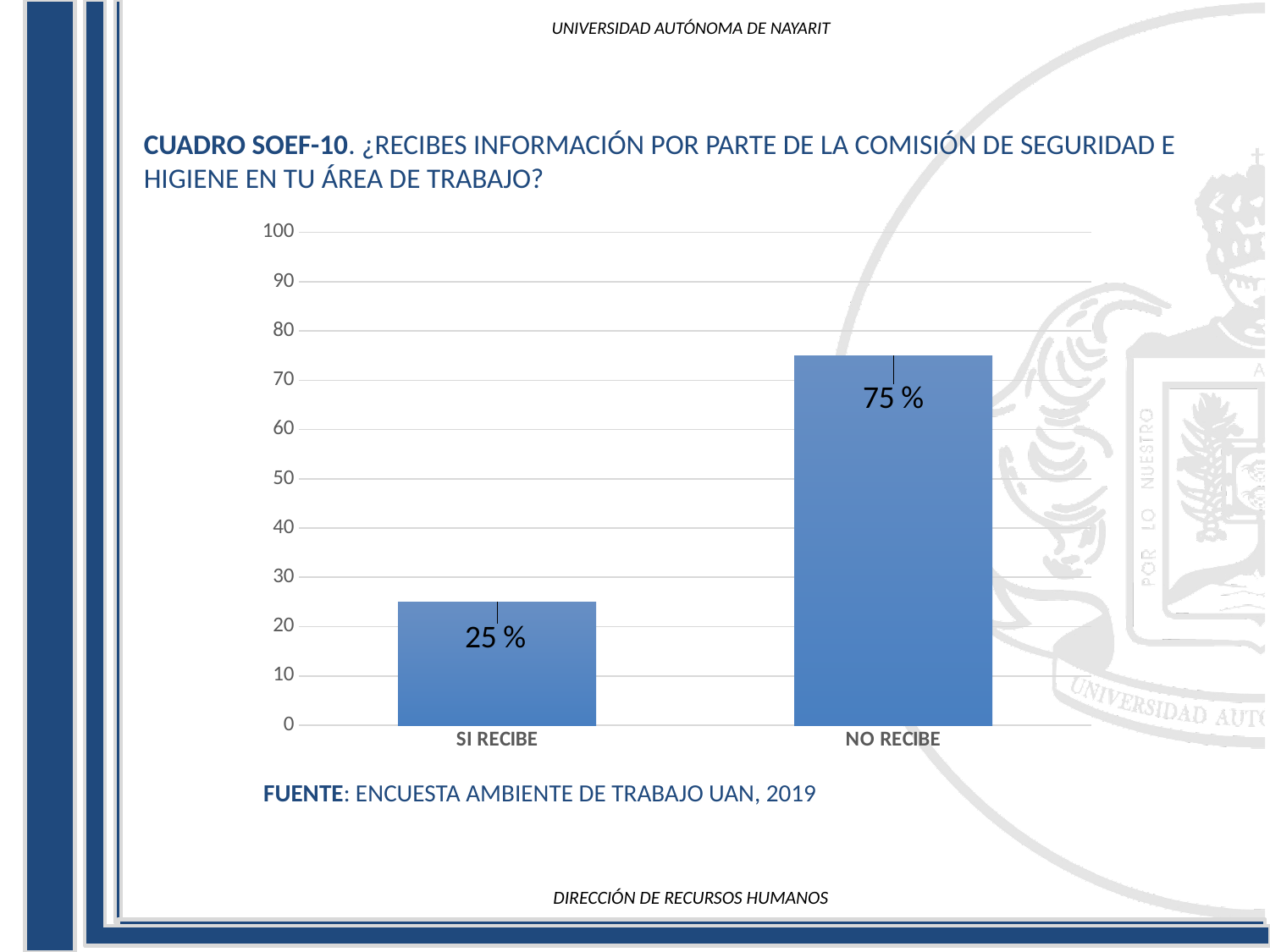
What is the difference between the values for NO RECIBE and SI RECIBE? 50 % What is the value for SI RECIBE? 25 % Is the value for NO RECIBE greater or less than 50? greater Which is larger, the value for SI RECIBE or the value for NO RECIBE? NO RECIBE What is the value for NO RECIBE? 75 % Which category has the lowest value? SI RECIBE Which category has the highest value? NO RECIBE What source is cited below the chart? ENCUESTA AMBIENTE DE TRABAJO UAN, 2019 What is the maximum value shown on the y axis? 100 How many categories are shown on the x axis? 2 What kind of chart is shown on the slide? bar chart Is the value for SI RECIBE greater or less than 30? less